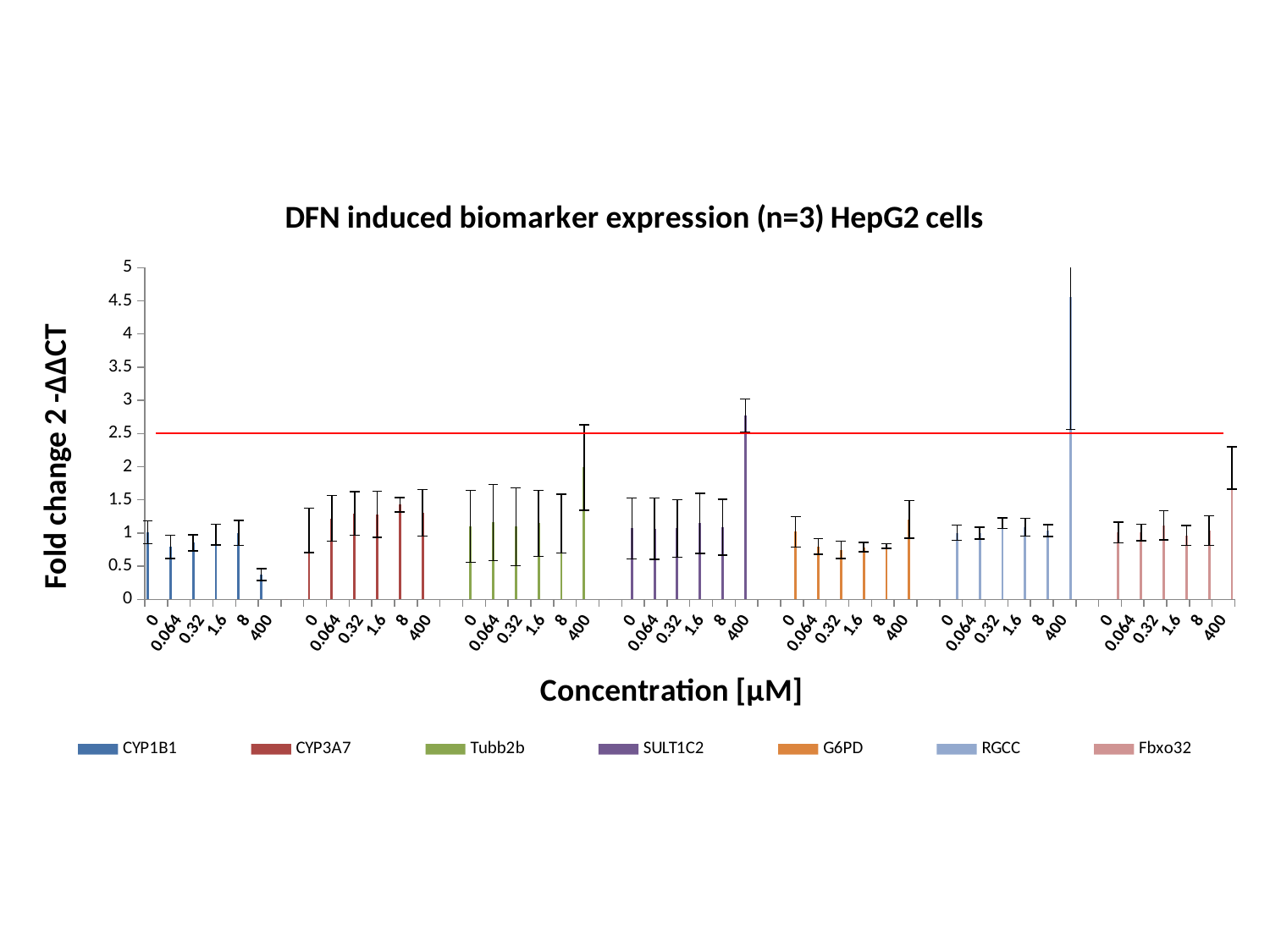
Is the value for CYP1B1 at 400 µM greater or less than 0.5? less At which concentration is the CYP1B1 value lowest? 400 Is the value for SULT1C2 at 400 µM greater or less than 2.5? greater How many concentration levels are plotted for each series? 6 What is the label of the x axis? Concentration [µM] Which is larger for Tubb2b: the value at 0 µM or the value at 400 µM? 400 µM Is the value for Tubb2b at 400 µM greater or less than 1.5? greater What kind of chart is shown on the slide? bar chart What is the title of the chart? DFN induced biomarker expression (n=3) HepG2 cells How many series does the legend list? 7